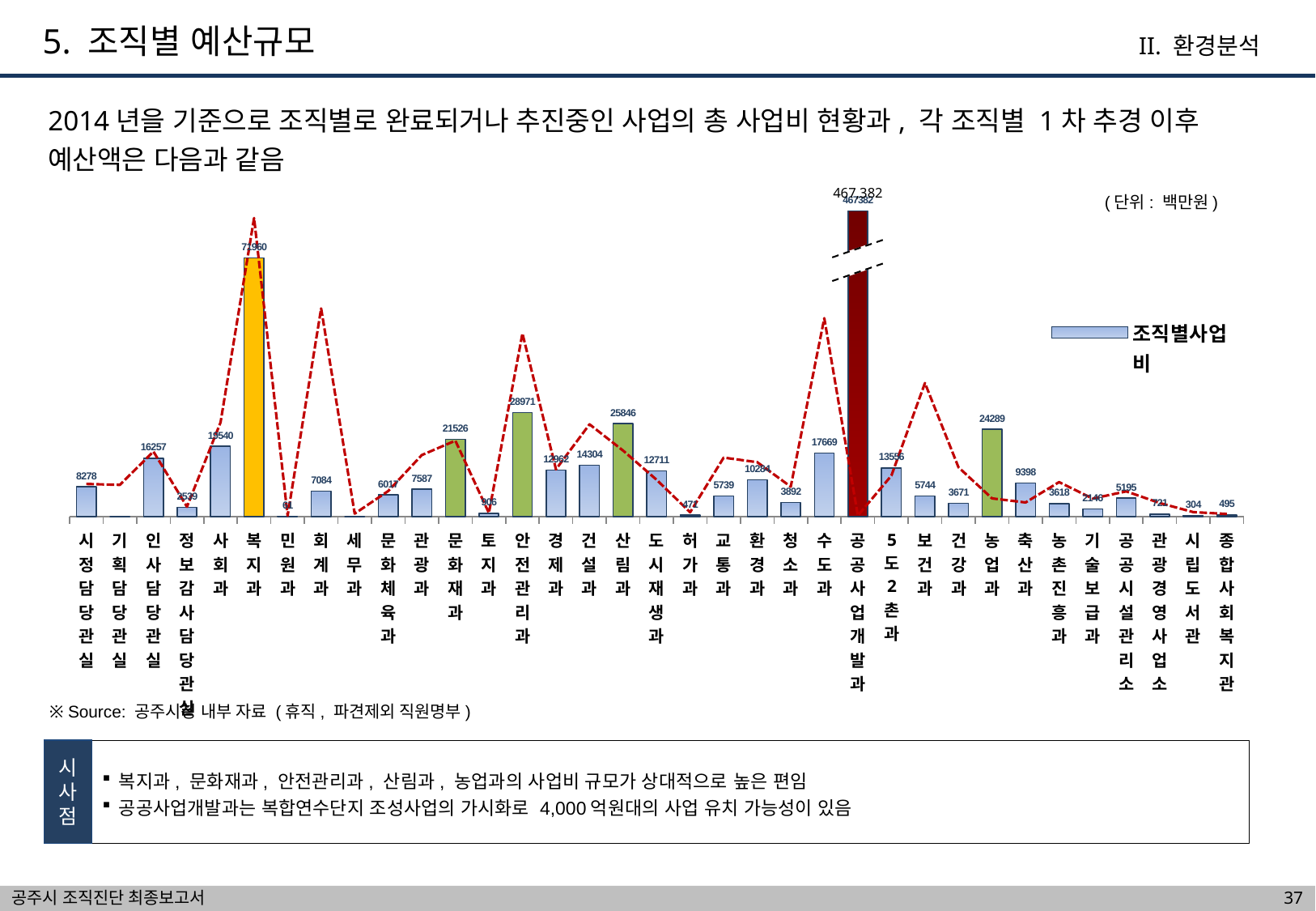
What unit is stated for the values in the chart? 백만원 How many series does the legend list? 1 What is the value for 안전관리과? 28971 What is the value for 산림과? 25846 What is the value for 공공사업개발과? 467382 What is the value for 농업과? 24289 What is the value for 시립도서관? 304 Which organization has the highest value? 공공사업개발과 Which is larger, the value for 건설과 or the value for 도시재생과? 건설과 What is the difference between the values for 산림과 and 문화재과? 4320 What type of chart is shown on the slide? bar and line chart What is the difference between the values for 안전관리과 and 농업과? 4682